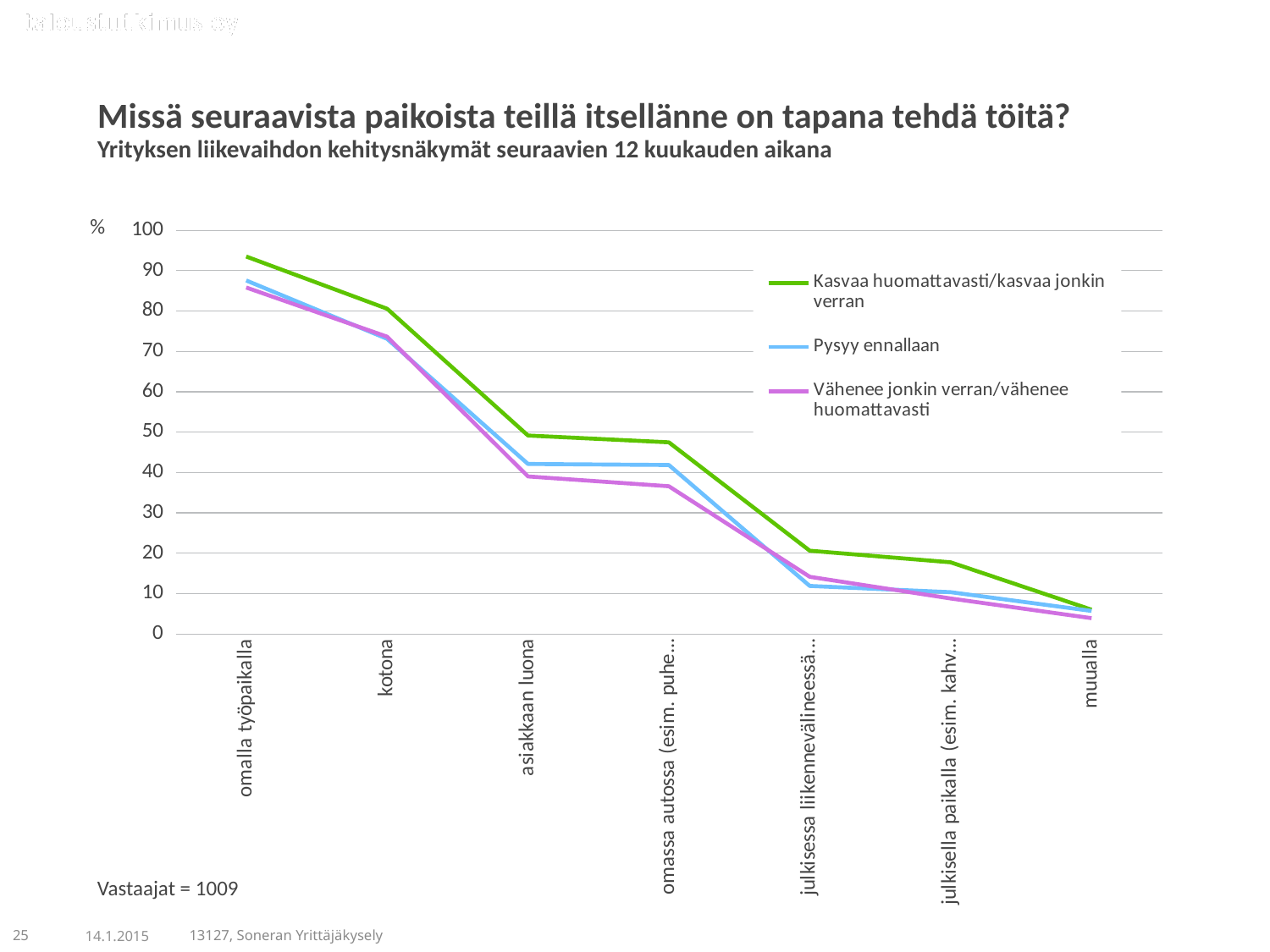
Do the values of the 'Kasvaa huomattavasti/kasvaa jonkin verran' series rise or fall from left to right along the x axis? fall How many respondents (Vastaajat) does the slide report? 1009 For the 'Pysyy ennallaan' series, which category has the lowest value? muualla At 'kotona', which series has the larger value: 'Kasvaa huomattavasti/kasvaa jonkin verran' or 'Vähenee jonkin verran/vähenee huomattavasti'? Kasvaa huomattavasti/kasvaa jonkin verran Is the value for 'asiakkaan luona' in the 'Pysyy ennallaan' series greater or less than 50? less How many series does the legend list? 3 Which series is drawn with the green line? Kasvaa huomattavasti/kasvaa jonkin verran What kind of chart is shown on the slide? line chart Is the value for 'omalla työpaikalla' in the 'Vähenee jonkin verran/vähenee huomattavasti' series greater or less than 80? greater How many categories are plotted along the x axis? 7 Is the value for 'kotona' in the 'Kasvaa huomattavasti/kasvaa jonkin verran' series greater or less than 70? greater For the 'Kasvaa huomattavasti/kasvaa jonkin verran' series, which category has the highest value? omalla työpaikalla